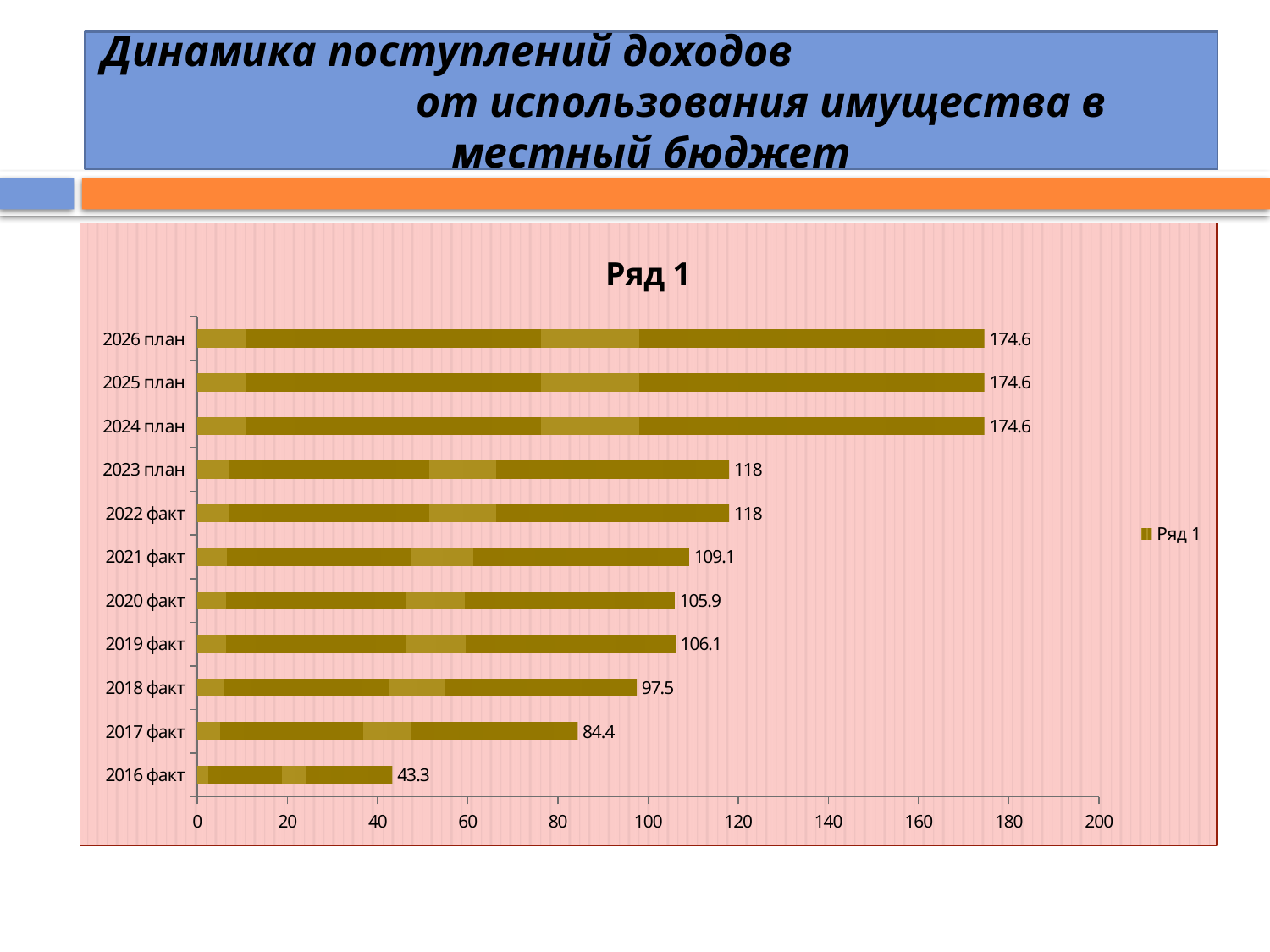
What is the difference between the values for 2017 факт and 2016 факт? 41.1 What is the value for 2016 факт? 43.3 What kind of chart is shown on the slide? bar chart Which category has the lowest value? 2016 факт What is the value for 2021 факт? 109.1 Which is larger, the value for 2018 факт or the value for 2020 факт? 2020 факт What is the value for 2024 план? 174.6 How many categories are shown on the chart? 11 What is the title of the chart? Ряд 1 How many series does the legend list? 1 What is the difference between the values for 2023 план and 2022 факт? 0 Is the value for 2019 факт greater or less than 100? greater